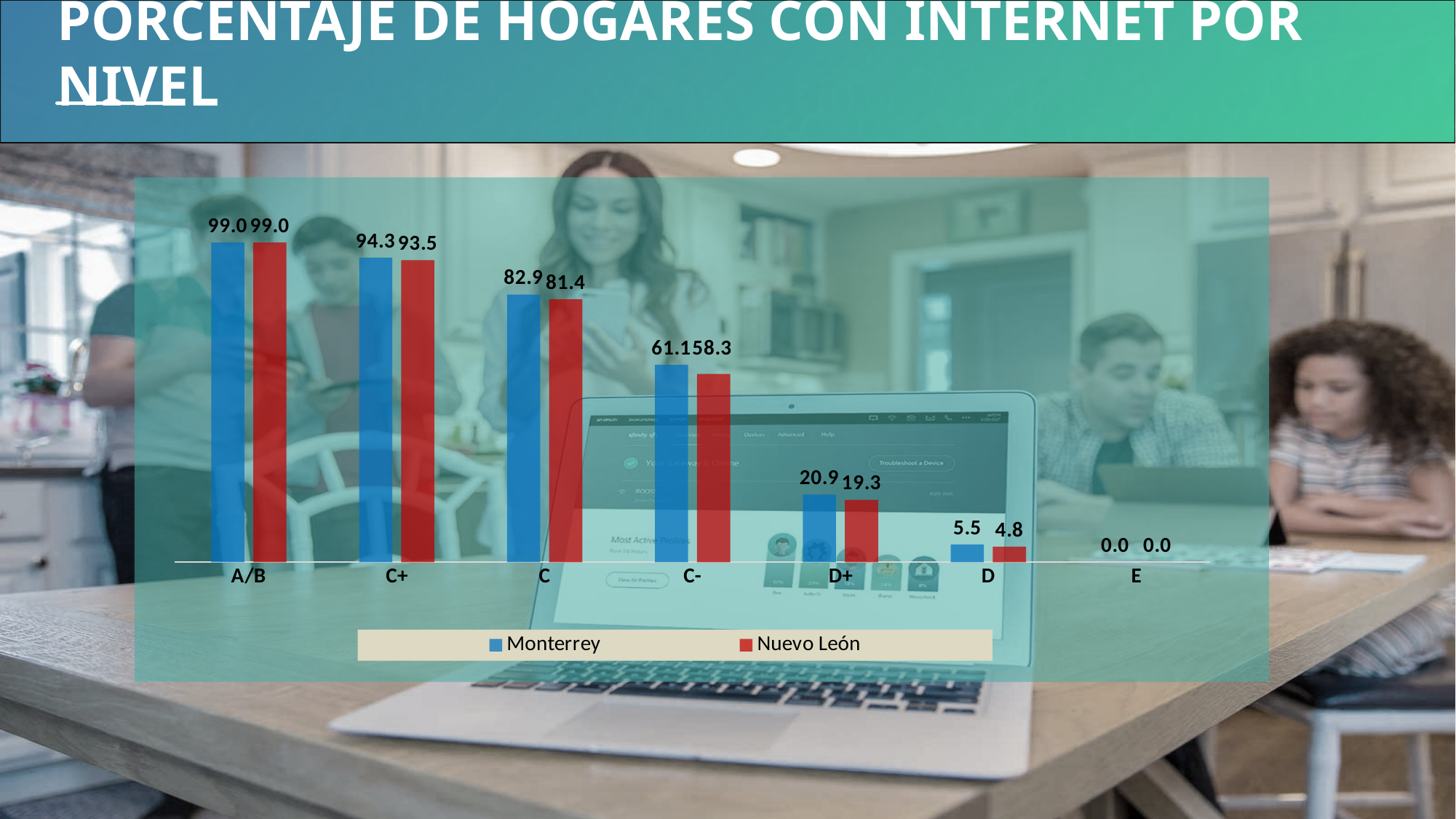
Which level has the highest value for Nuevo León? A/B What is the value for Monterrey at level C+? 94.3 What is the value for Nuevo León at level C? 81.4 What kind of chart is shown on the slide? Bar chart How many series does the legend list? 2 What is the difference between the Monterrey and Nuevo León values at level C-? 2.8 Which level has the lowest value for Monterrey? E At level C, which is larger: Monterrey or Nuevo León? Monterrey What is the value for Nuevo León at level D+? 19.3 What is the value for Monterrey at level D? 5.5 How many levels are shown on the x axis? 7 Do the Monterrey values rise or fall from A/B to E? Fall